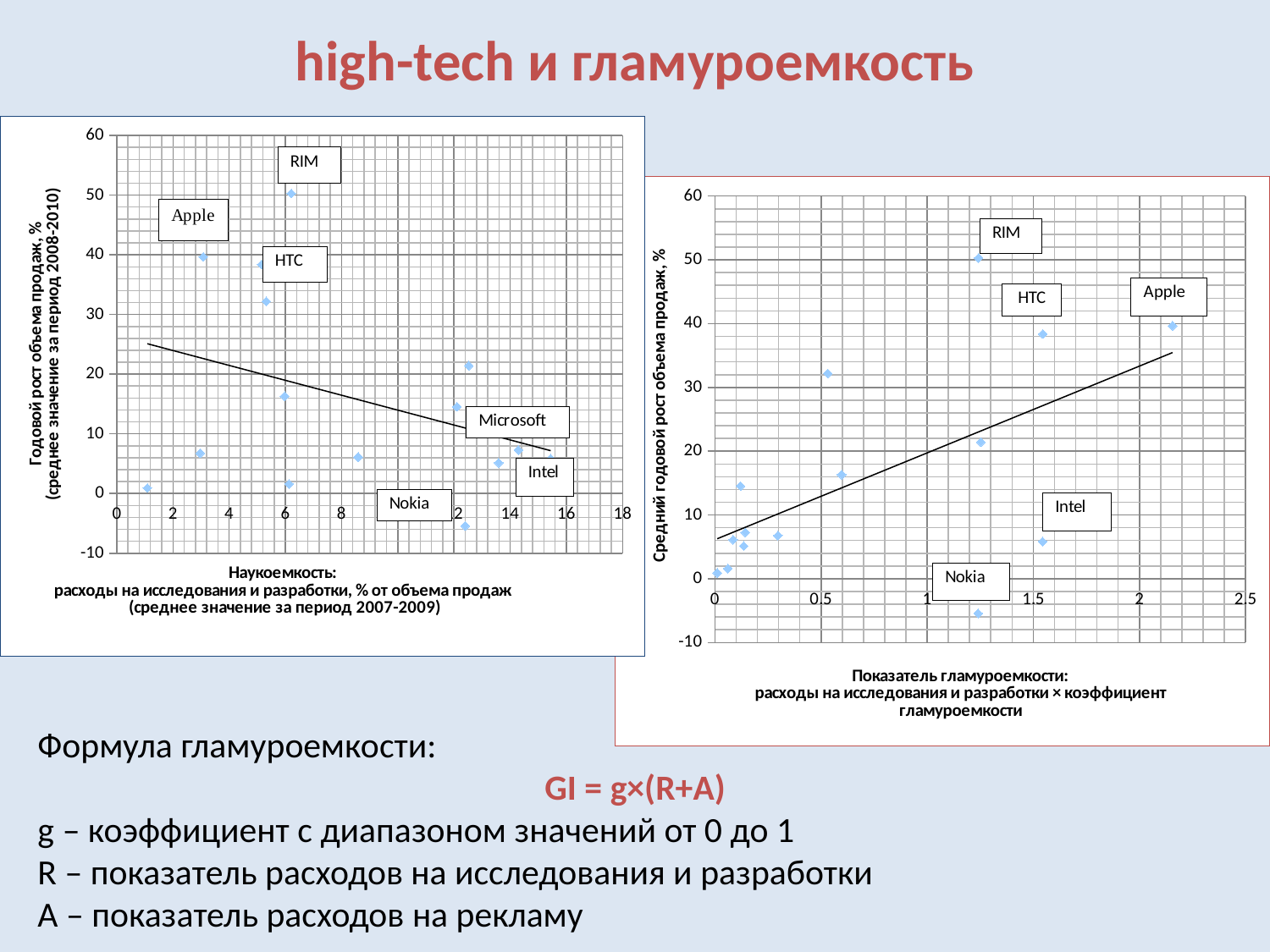
In the right chart, is the sales growth value for Intel greater or less than 10? less In the left chart, which labeled company has the lowest annual sales growth? Nokia In the right chart, does the trend line rise or fall as the glamour index (x axis) increases? rises In the left chart, does the trend line rise or fall as R&D intensity (x axis) increases? falls In the right chart, which has the higher sales growth, Intel or Nokia? Intel In the left chart, is the sales growth value for Nokia greater or less than 0? less In the left chart, is the sales growth value for RIM greater or less than 40? greater In the right chart, which labeled company has the highest glamour index (x-axis value)? Apple How many company labels are shown on the right chart? 5 In the left chart, which labeled company has the highest annual sales growth? RIM What kind of chart is the left chart on the slide? scatter chart